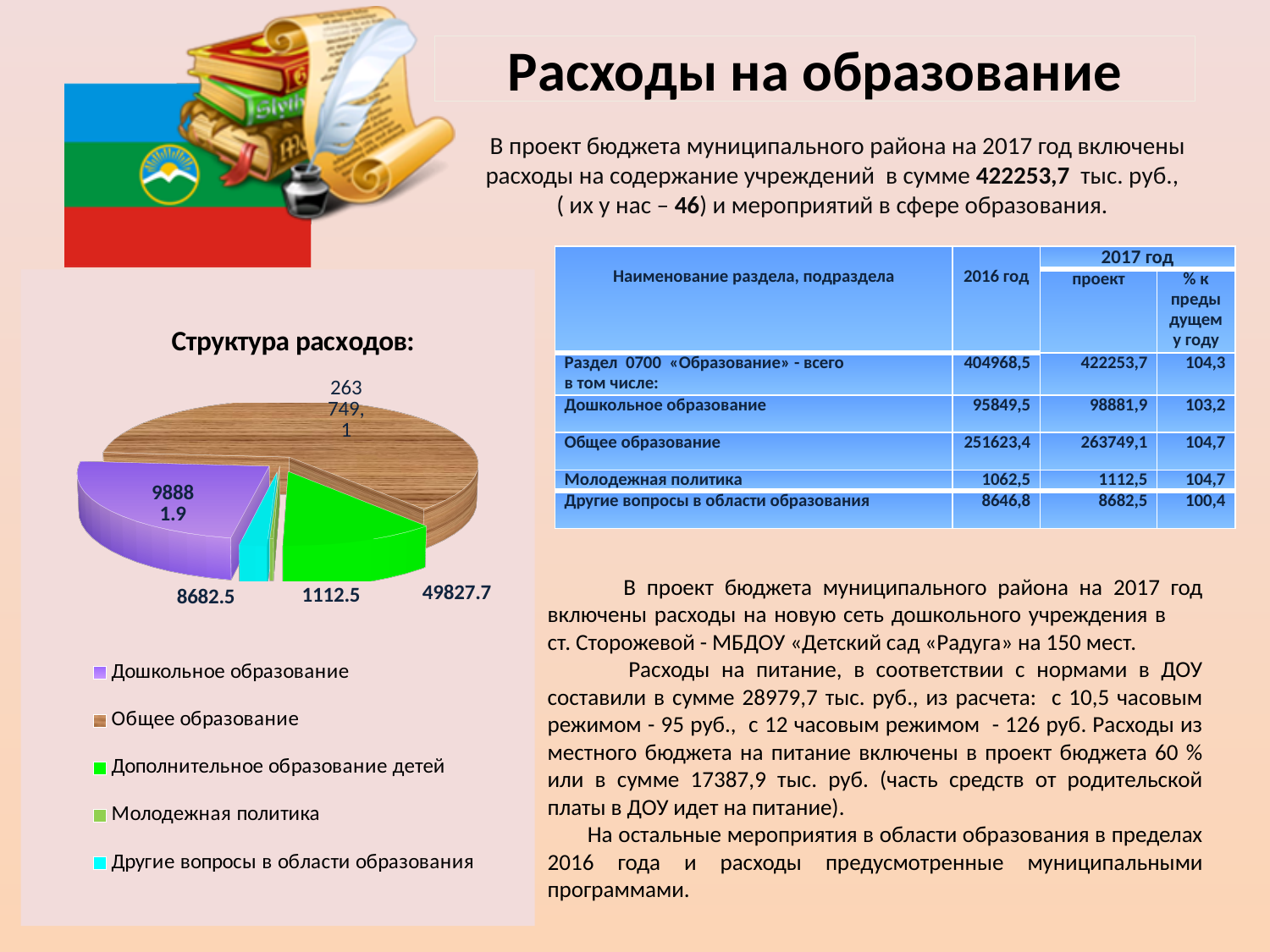
What colour is the "Дошкольное образование" slice in the pie chart? purple What value is labelled for "Дошкольное образование" in the pie chart? 98881.9 In the pie chart, what is the difference between the values for "Дополнительное образование детей" and "Другие вопросы в области образования"? 41145.2 Which category has the largest slice in the "Структура расходов:" pie chart? Общее образование What value is labelled for "Другие вопросы в области образования" in the pie chart? 8682.5 What kind of chart is shown under the title "Структура расходов:"? pie chart What value is labelled for "Дополнительное образование детей" in the pie chart? 49827.7 How many entries does the legend of the "Структура расходов:" pie chart list? 5 In the pie chart, what is the difference between the values for "Другие вопросы в области образования" and "Молодежная политика"? 7570 What value is labelled for "Молодежная политика" in the pie chart? 1112.5 In the pie chart, which is larger: "Дошкольное образование" or "Дополнительное образование детей"? Дошкольное образование Which category has the smallest slice in the "Структура расходов:" pie chart? Молодежная политика